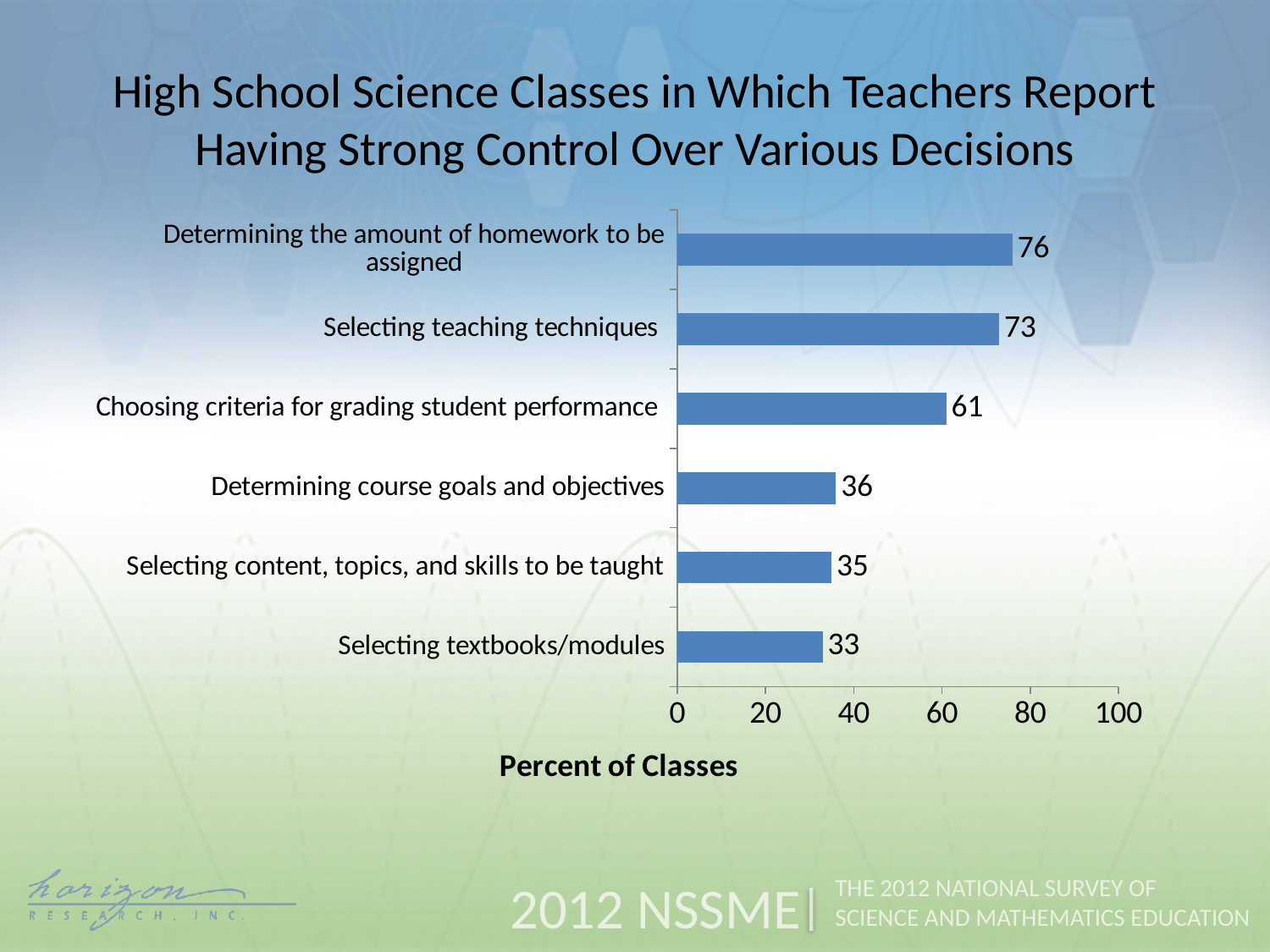
How many decision categories are shown in the chart? 6 What kind of chart is shown on the slide? Bar chart What is the value for choosing criteria for grading student performance? 61 What is the difference between the values for selecting teaching techniques and determining course goals and objectives? 37 What is the value for selecting teaching techniques? 73 What is the value for selecting textbooks/modules? 33 Is the value for determining course goals and objectives greater or less than 40? less What is the label of the horizontal axis? Percent of Classes Which is larger: the value for choosing criteria for grading student performance or the value for selecting content, topics, and skills to be taught? Choosing criteria for grading student performance Which decision has the lowest percent of classes? Selecting textbooks/modules What percent of classes report strong control over determining the amount of homework to be assigned? 76 Which decision has the highest percent of classes? Determining the amount of homework to be assigned